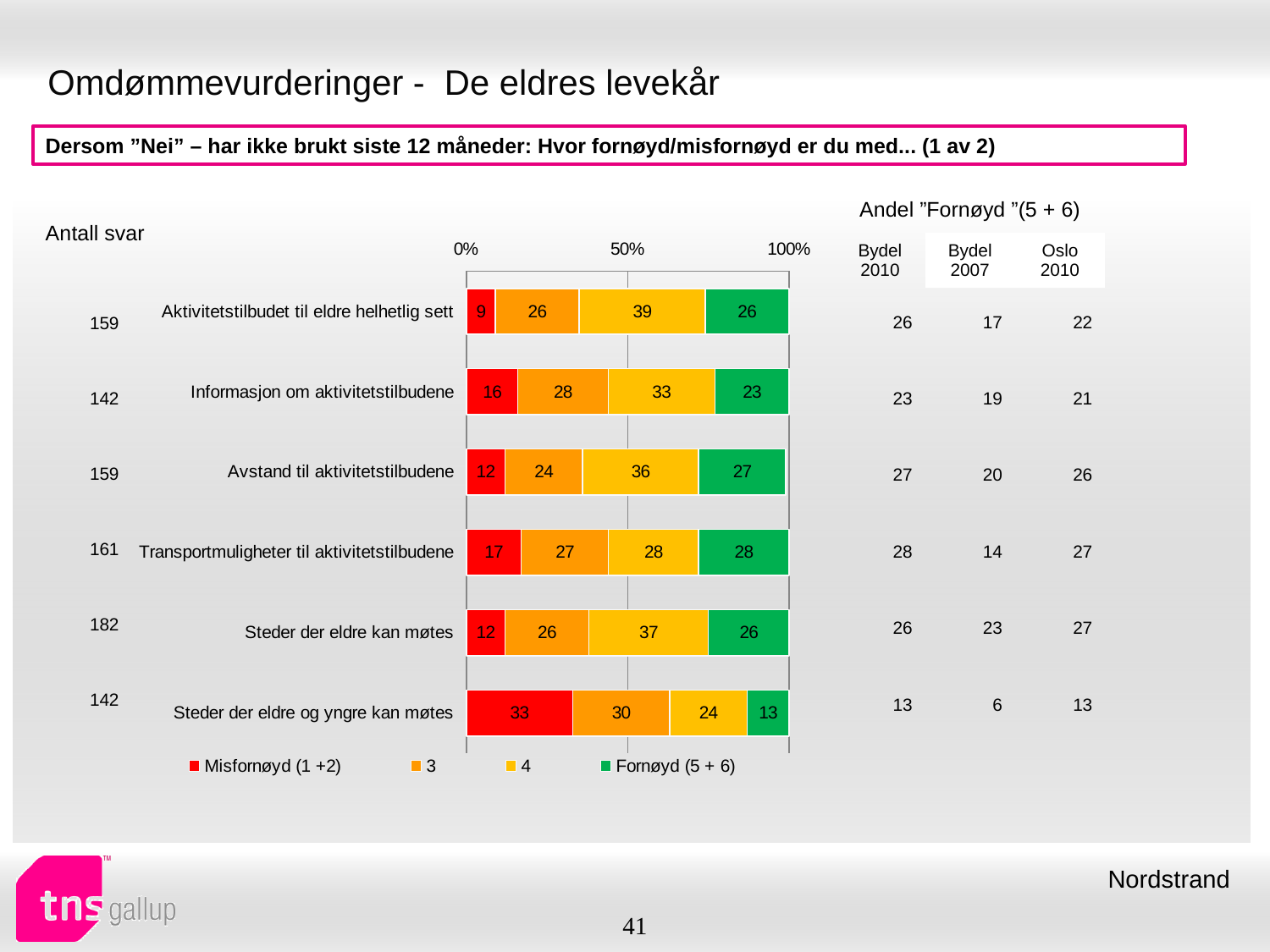
What is the value of series "4" for "Steder der eldre kan møtes"? 37 What is the total of the stacked bar for "Transportmuligheter til aktivitetstilbudene"? 100 What is the value of "Fornøyd (5 + 6)" for "Aktivitetstilbudet til eldre helhetlig sett"? 26 What is the value of "Misfornøyd (1 +2)" for "Informasjon om aktivitetstilbudene"? 16 How many categories are plotted in the chart? 6 What is the difference between the "Misfornøyd (1 +2)" values for "Steder der eldre og yngre kan møtes" and "Aktivitetstilbudet til eldre helhetlig sett"? 24 What is the value of series "3" for "Transportmuligheter til aktivitetstilbudene"? 27 Which is larger: the "Fornøyd (5 + 6)" value for "Avstand til aktivitetstilbudene" or for "Informasjon om aktivitetstilbudene"? Avstand til aktivitetstilbudene Which category has the highest "Misfornøyd (1 +2)" value? Steder der eldre og yngre kan møtes How many series does the chart legend list? 4 Which category has the lowest "Fornøyd (5 + 6)" value? Steder der eldre og yngre kan møtes What kind of chart is shown on the slide? stacked bar chart